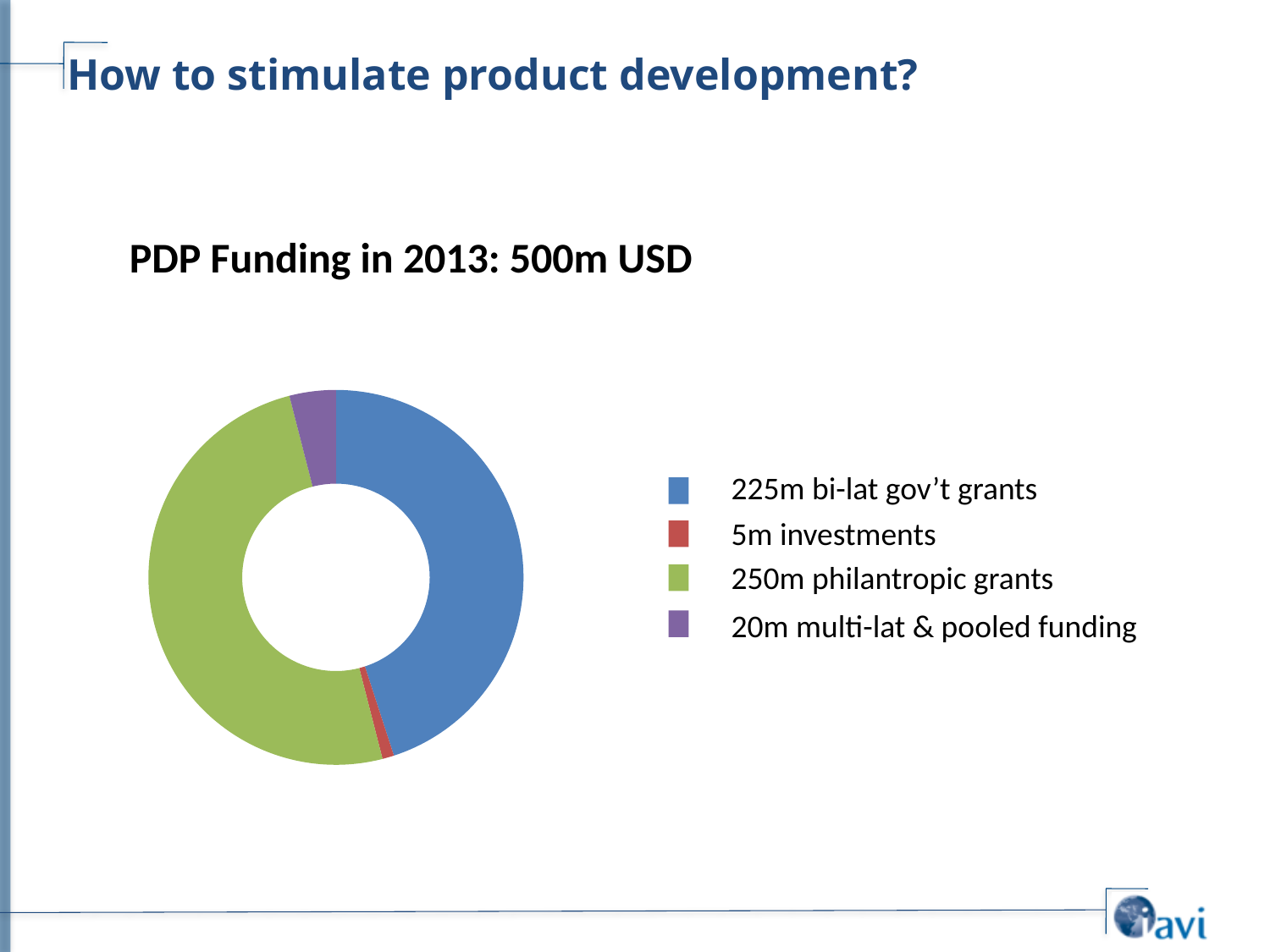
What is the value for multi-lat & pooled funding? 20m Which is larger, multi-lat & pooled funding or investments? Multi-lat & pooled funding Which funding category is the largest? Philanthropic grants What is the value for investments? 5m What is the value for philanthropic grants? 250m What kind of chart is shown on the slide? Doughnut chart What share of the total PDP funding in 2013 do philanthropic grants represent? 50% What is the difference between philanthropic grants and bi-lat gov't grants? 25m What is the value for bi-lat gov't grants? 225m Which funding category is the smallest? Investments How many funding categories does the chart show? 4 What colour represents philanthropic grants in the chart? Green